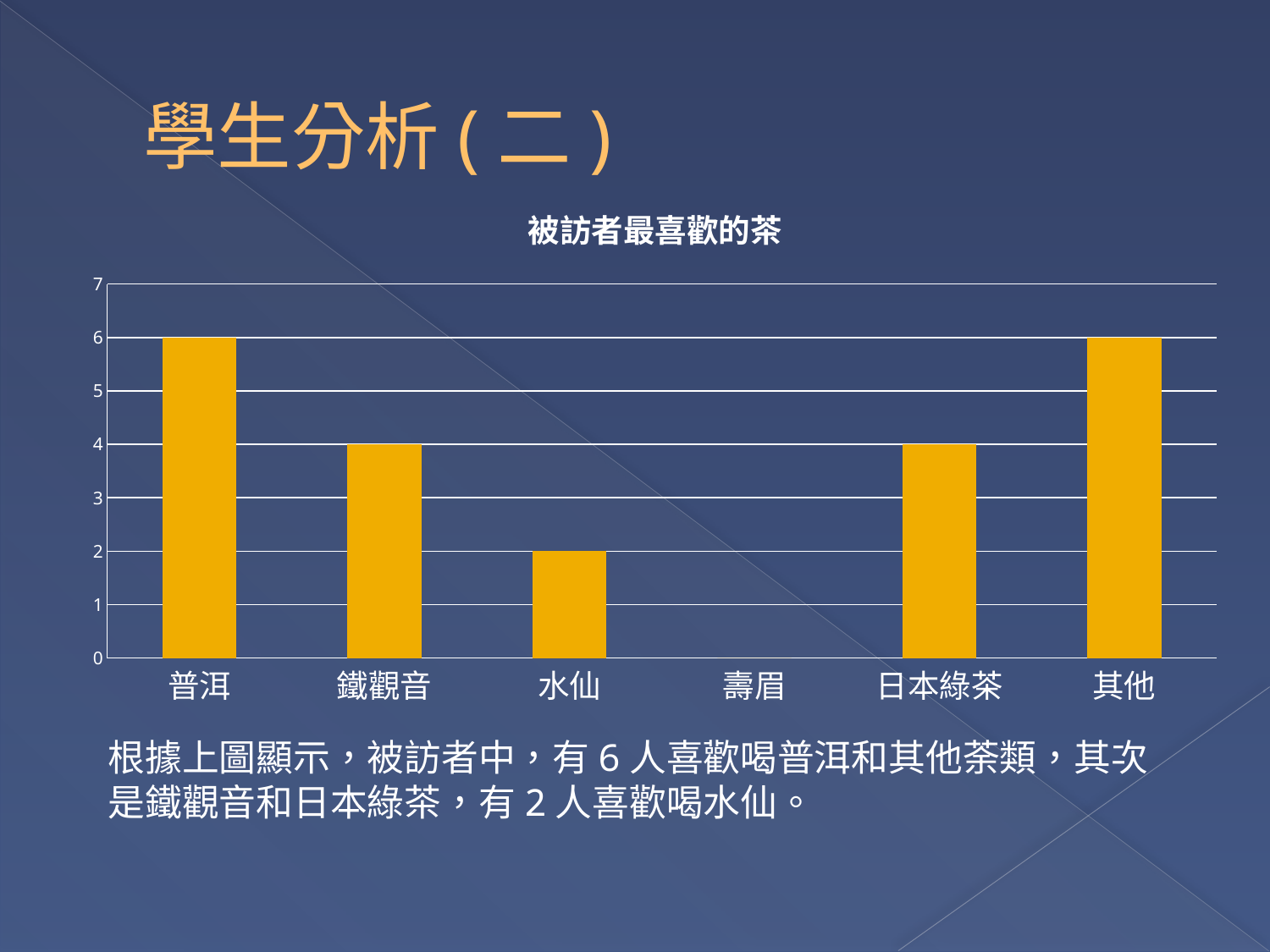
How many tea categories are shown on the x axis of the chart? 6 What is the title of the chart? 被訪者最喜歡的茶 What is the value for 日本綠茶? 4 Is the value for 鐵觀音 greater or less than 3? greater Is the value for 水仙 greater or less than 5? less What is the difference between the value for 其他 and the value for 水仙? 4 Which is larger, the value for 普洱 or the value for 鐵觀音? 普洱 What type of chart is shown on the slide? Bar chart What is the value for 壽眉? 0 Which category has the lowest value? 壽眉 What is the value for 水仙? 2 What is the value for 普洱? 6